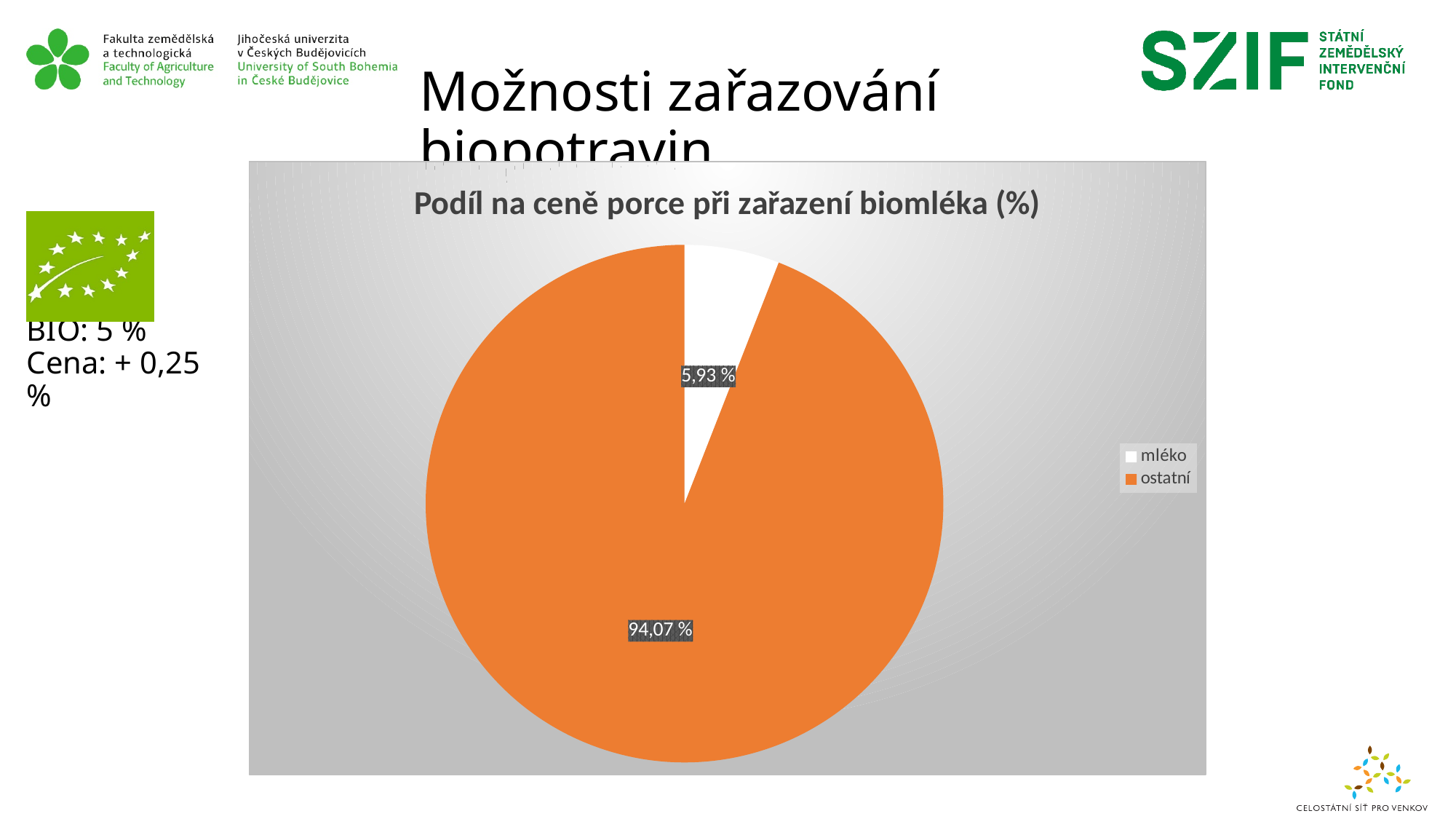
Which slice is the smallest? mléko How many slices does the pie chart have? 2 What is the value shown for the 'ostatní' slice? 94,07 % What share of the pie does the 'mléko' slice represent? 5,93 % What colour is the 'ostatní' slice? orange What is the title of the chart? Podíl na ceně porce při zařazení biomléka (%) Which slice is the largest? ostatní What is the value shown for the 'mléko' slice? 5,93 % What is the difference between the 'ostatní' and 'mléko' values? 88,14 % Which is larger, the 'mléko' slice or the 'ostatní' slice? ostatní How many entries does the legend list? 2 What kind of chart is shown on the slide? pie chart